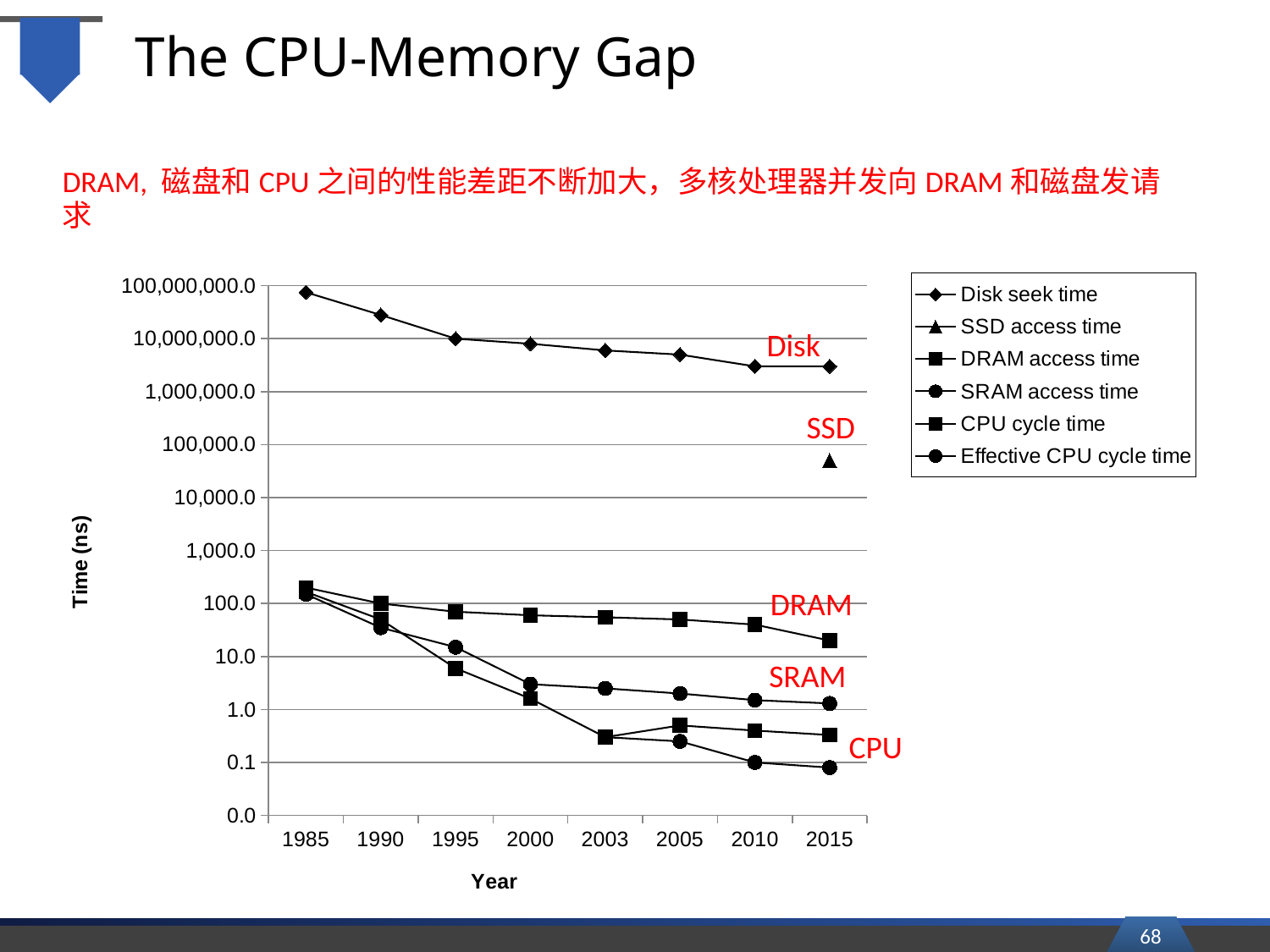
How many data points are plotted for SSD access time? 1 In 2015, which is larger: DRAM access time or SRAM access time? DRAM access time How many years are shown on the x axis? 8 Does Disk seek time rise or fall from 1985 to 2015? fall Is the SSD access time value for 2015 greater or less than 100,000.0? less Which series has the highest value in 2015? Disk seek time What kind of chart is shown on the slide? line chart Is the DRAM access time value for 2015 greater or less than 10.0? greater How many series does the legend list? 6 Is the Disk seek time value for 1985 greater or less than 10,000,000.0? greater What is the label of the y axis? Time (ns)